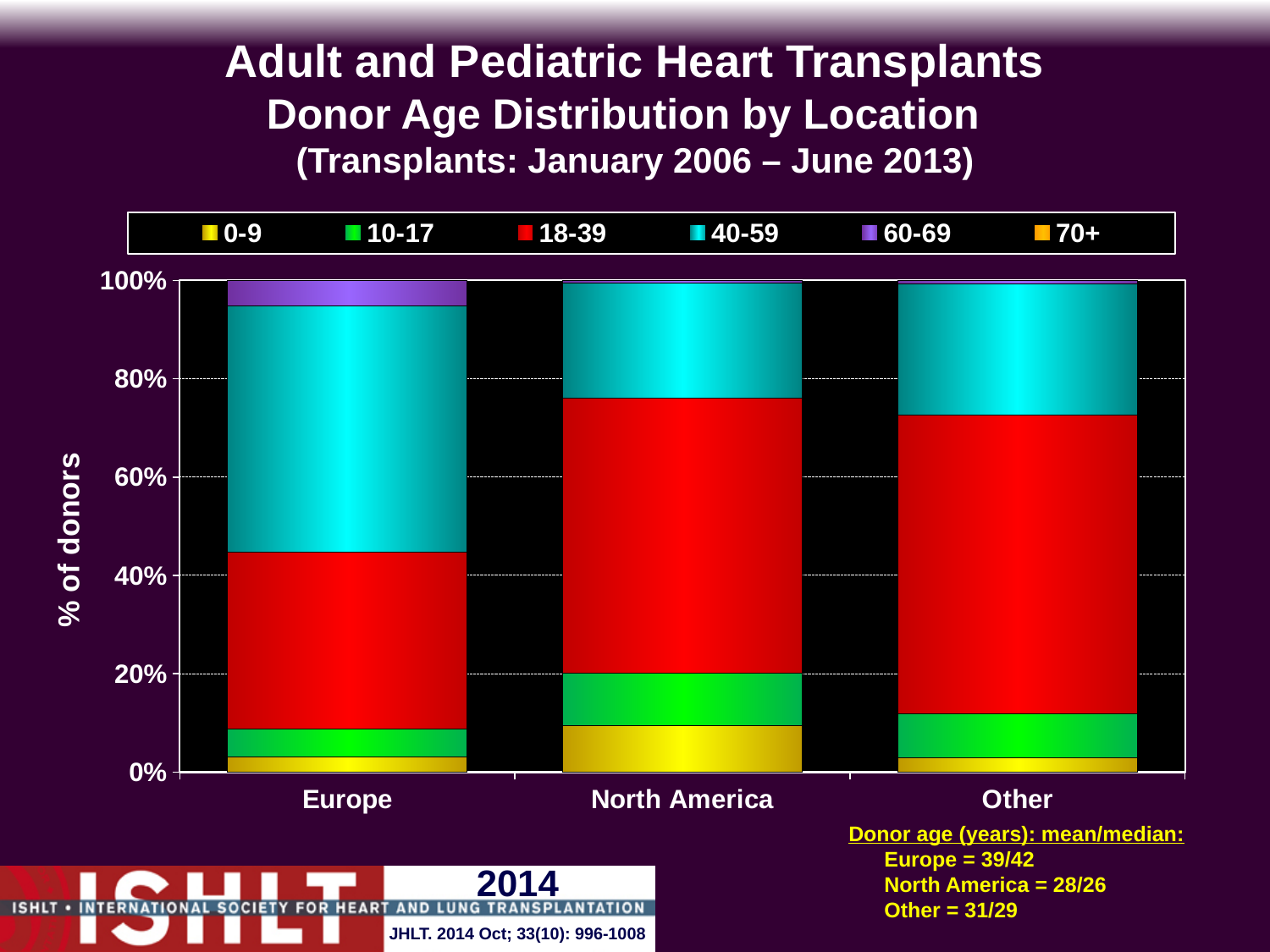
Which location has the largest share of 0-9 donors? North America Is the share of 18-39 donors for North America greater or less than 40%? greater Which age group is shown in red in the legend? 18-39 What is the label of the y axis? % of donors What kind of chart is shown on the slide? Stacked bar chart Which has the larger share of 18-39 donors, Europe or North America? North America Which location has the largest share of 40-59 donors? Europe How many donor age groups does the legend list? 6 How many locations are shown on the x axis of the chart? 3 Is the share of 0-9 donors for North America greater or less than 20%? less Is the share of 40-59 donors for Europe greater or less than 40%? greater